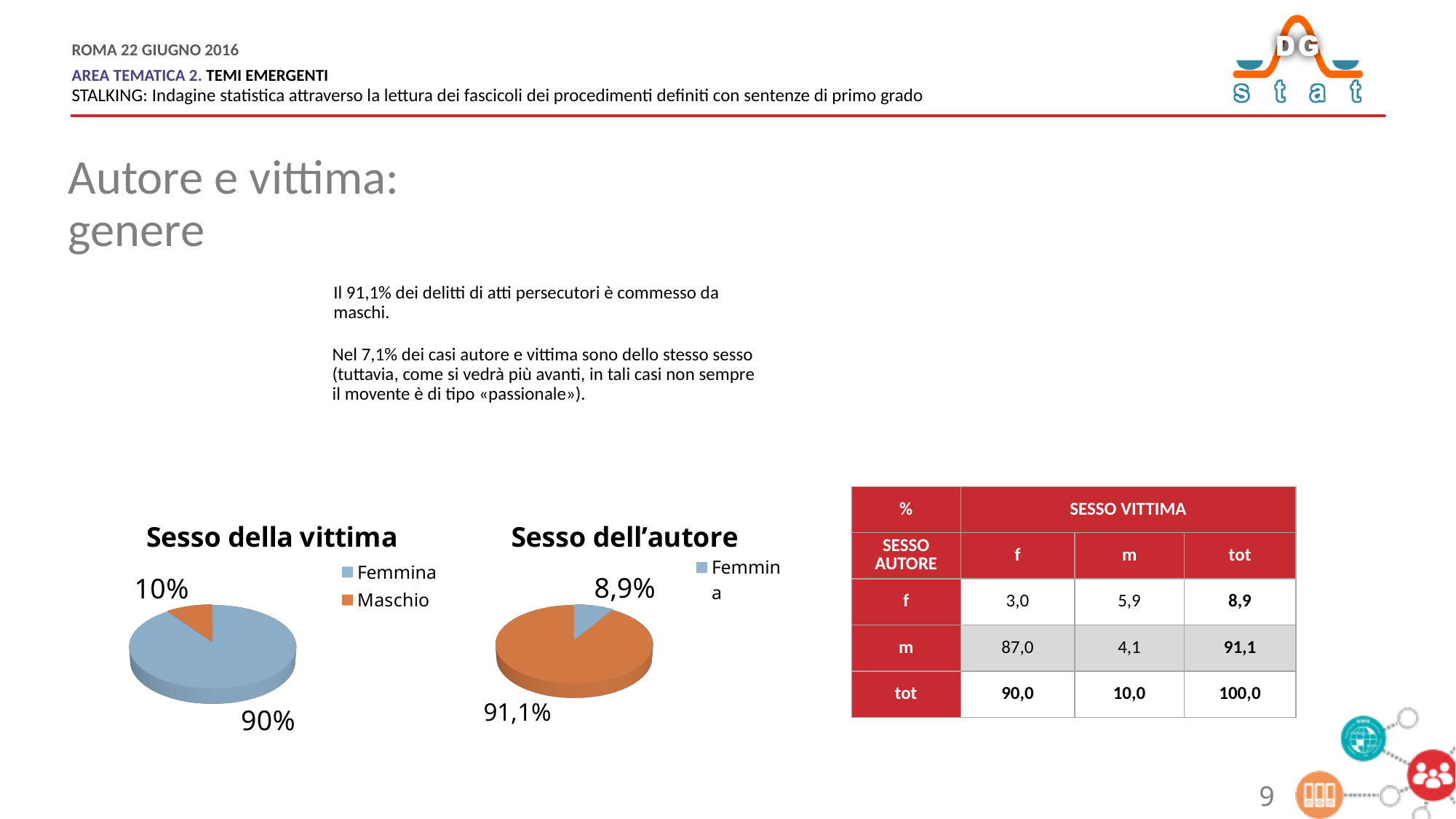
In the 'Sesso dell'autore' chart, what percentage is shown for the largest slice? 91,1% In the 'Sesso dell'autore' chart, what percentage is shown for Femmina? 8,9% In the 'Sesso dell'autore' chart, is the Femmina slice larger or smaller than the other slice? smaller In the 'Sesso della vittima' chart, what colour is the Maschio slice? orange In the 'Sesso della vittima' chart, which category has the largest slice? Femmina In the 'Sesso della vittima' chart, what is the difference between the Femmina and Maschio shares? 80% In the 'Sesso della vittima' chart, which category has the smallest slice? Maschio How many entries does the legend of the 'Sesso della vittima' chart list? 2 How many slices does the 'Sesso dell'autore' pie chart have? 2 In the 'Sesso della vittima' chart, what percentage of victims are Maschio? 10% In the 'Sesso della vittima' chart, what percentage of victims are Femmina? 90% What type of chart is 'Sesso della vittima'? pie chart